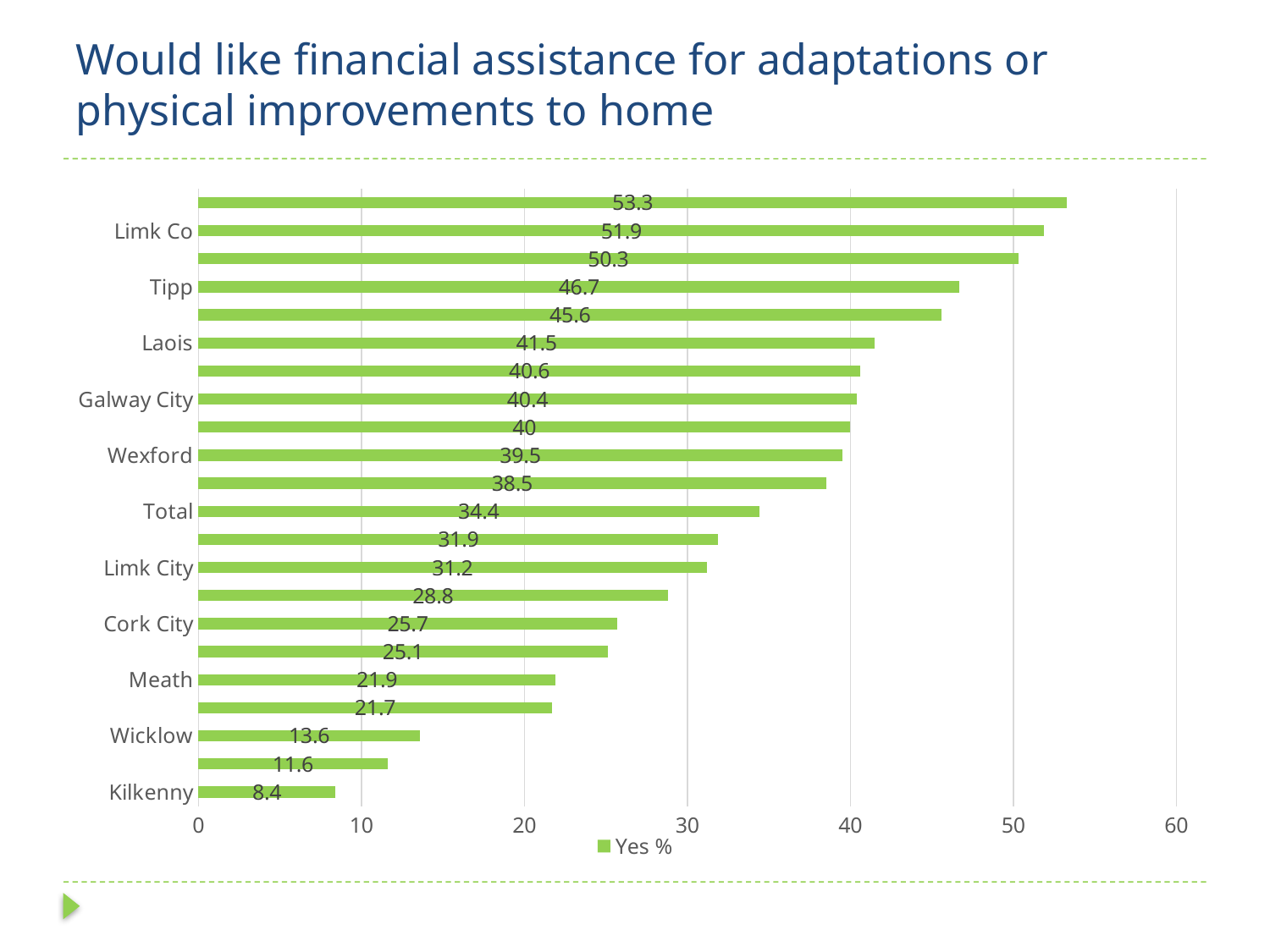
How many bars are plotted on the chart? 22 Is the Yes % value for Meath greater or less than 20? greater Which labelled category has the lowest Yes % value? Kilkenny What is the Yes % value for Limk City? 31.2 What is the Yes % value for Limk Co? 51.9 What is the difference between the Yes % values for Cork City and Wicklow? 12.1 What is the highest Yes % value shown on the chart? 53.3 What kind of chart is shown on the slide? bar chart What is the difference between the Yes % values for Tipp and Laois? 5.2 What is the Yes % value for Total? 34.4 What is the Yes % value for Kilkenny? 8.4 Which has a higher Yes % value, Galway City or Wexford? Galway City